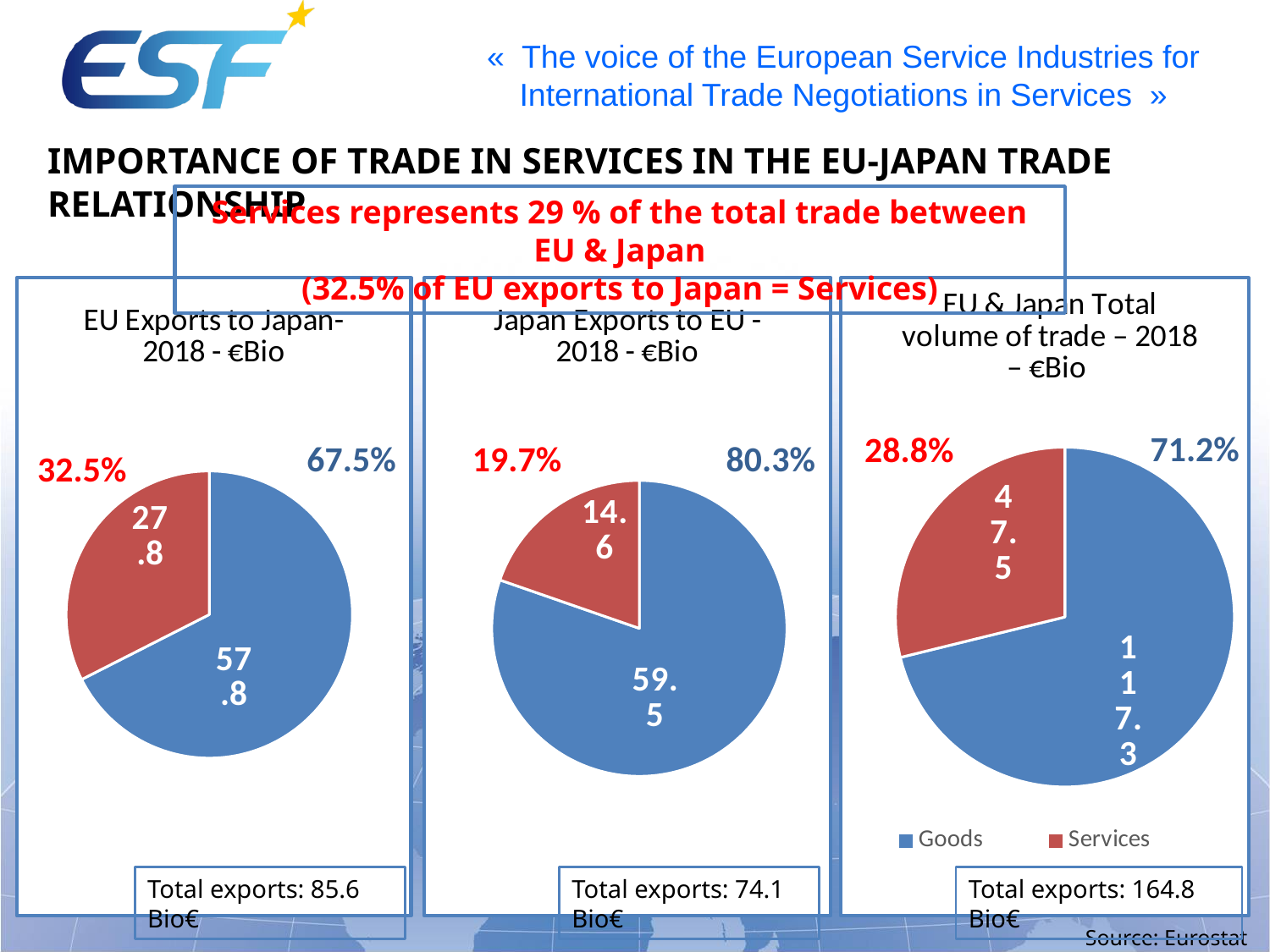
In the 'Japan Exports to EU - 2018 - €Bio' chart, what is the value of the Goods slice? 59.5 In the 'EU Exports to Japan- 2018 - €Bio' chart, what share of the pie is Services? 32.5% In the 'EU Exports to Japan- 2018 - €Bio' chart, what is the difference between the Goods and Services values? 30.0 In the 'Japan Exports to EU - 2018 - €Bio' chart, which slice is larger, Goods or Services? Goods In the 'EU Exports to Japan- 2018 - €Bio' chart, what is the value of the Services slice? 27.8 How many entries does the legend of the 'EU & Japan Total volume of trade – 2018 – €Bio' chart list? 2 In the 'EU & Japan Total volume of trade – 2018 – €Bio' chart, what share of the pie is Services? 28.8% In the 'Japan Exports to EU - 2018 - €Bio' chart, what share of the pie is Goods? 80.3% In the 'EU & Japan Total volume of trade – 2018 – €Bio' chart, what is the value of the Goods slice? 117.3 In the 'Japan Exports to EU - 2018 - €Bio' chart, what is the value of the Services slice? 14.6 What kind of chart is the 'EU & Japan Total volume of trade – 2018 – €Bio' chart? Pie chart In the 'EU Exports to Japan- 2018 - €Bio' chart, what is the value of the Goods slice? 57.8